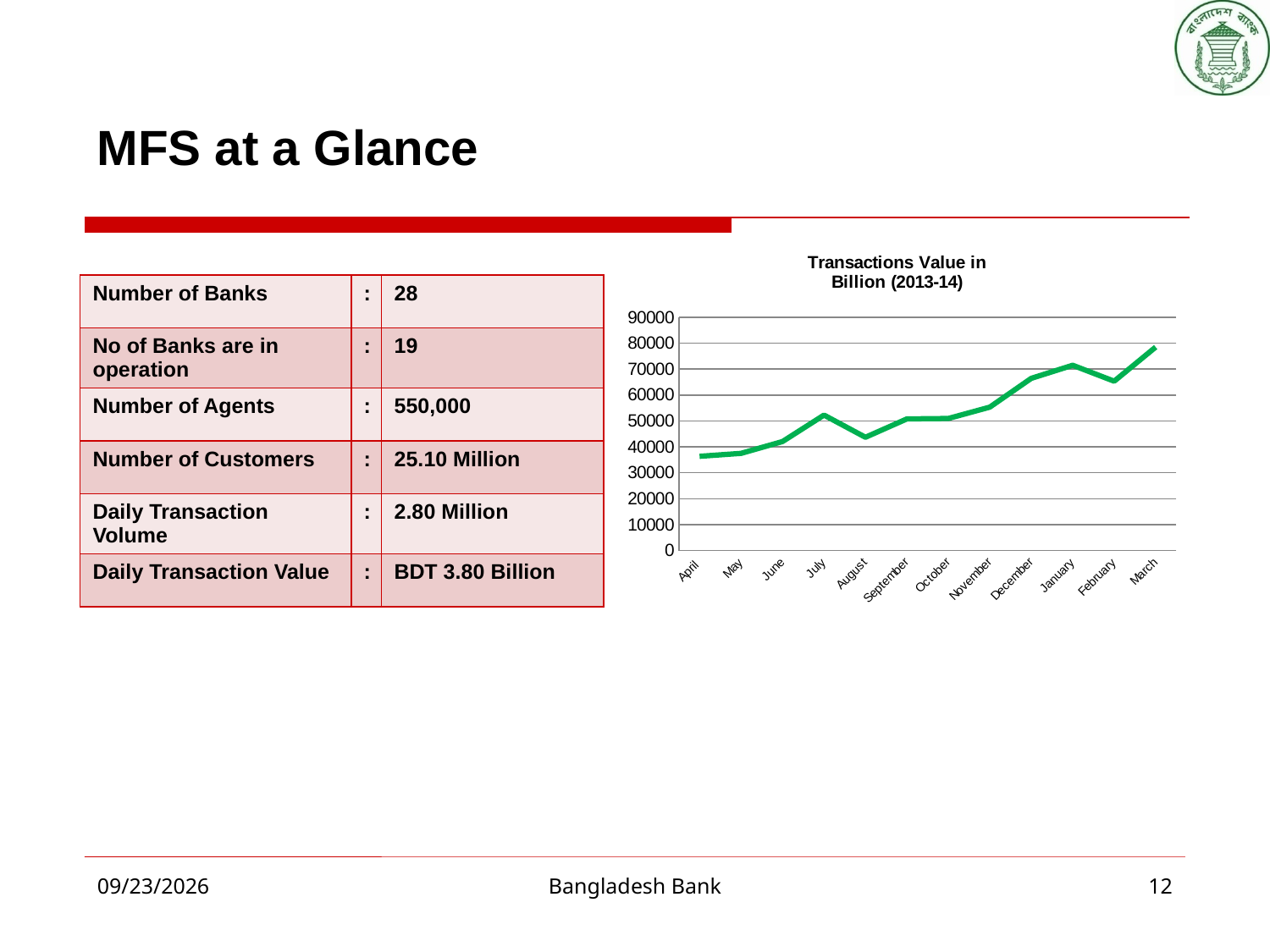
Which month has the highest transactions value in the chart? March Is the value for January greater or less than 60000? greater What kind of chart is shown on the slide? line chart Is the value for March greater or less than 70000? greater Is the value for August greater or less than 50000? less How many months are plotted on the x axis of the chart? 12 Which month has the larger transactions value, January or February? January Which month has the lowest transactions value in the chart? April Overall, do the transactions values rise or fall from April to March? rise What is the title of the chart? Transactions Value in Billion (2013-14) Which month has the larger transactions value, July or August? July